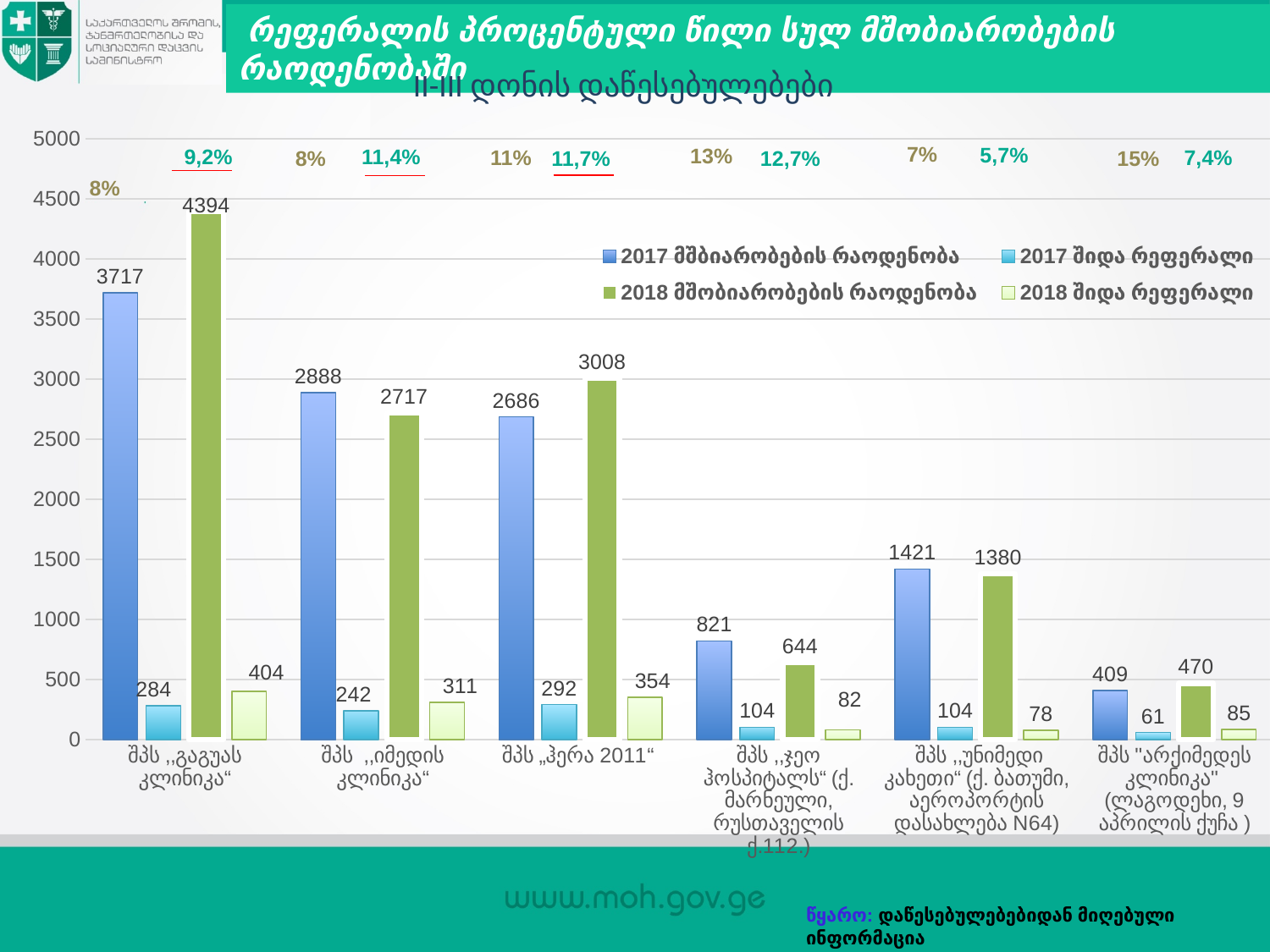
What is the 2018 შიდა რეფერალი value for შპს „იმედის კლინიკა“? 311 What percentage is printed above the 2018 bars for შპს „ჯეო ჰოსპიტალს“? 12,7% How many clinics (categories) are shown on the x axis? 6 How many series does the legend list? 4 What is the difference between the 2018 and 2017 მშობიარობების რაოდენობა values for შპს „გაგუას კლინიკა“? 677 For შპს „იმედის კლინიკა“, which is larger: the 2017 მშობიარობების რაოდენობა or the 2018 მშობიარობების რაოდენობა? 2017 მშობიარობების რაოდენობა Which clinic has the lowest 2017 მშობიარობების რაოდენობა value? შპს "არქიმედეს კლინიკა" What type of chart is shown on the slide? bar chart What is the 2018 მშობიარობების რაოდენობა value for შპს „პერა 2011“? 3008 What is the 2017 მშობიარობების რაოდენობა value for შპს „გაგუას კლინიკა“? 3717 Which clinic has the highest 2018 მშობიარობების რაოდენობა value? შპს „გაგუას კლინიკა“ What is the 2017 შიდა რეფერალი value for შპს „უნიმედი კახეთი“? 104